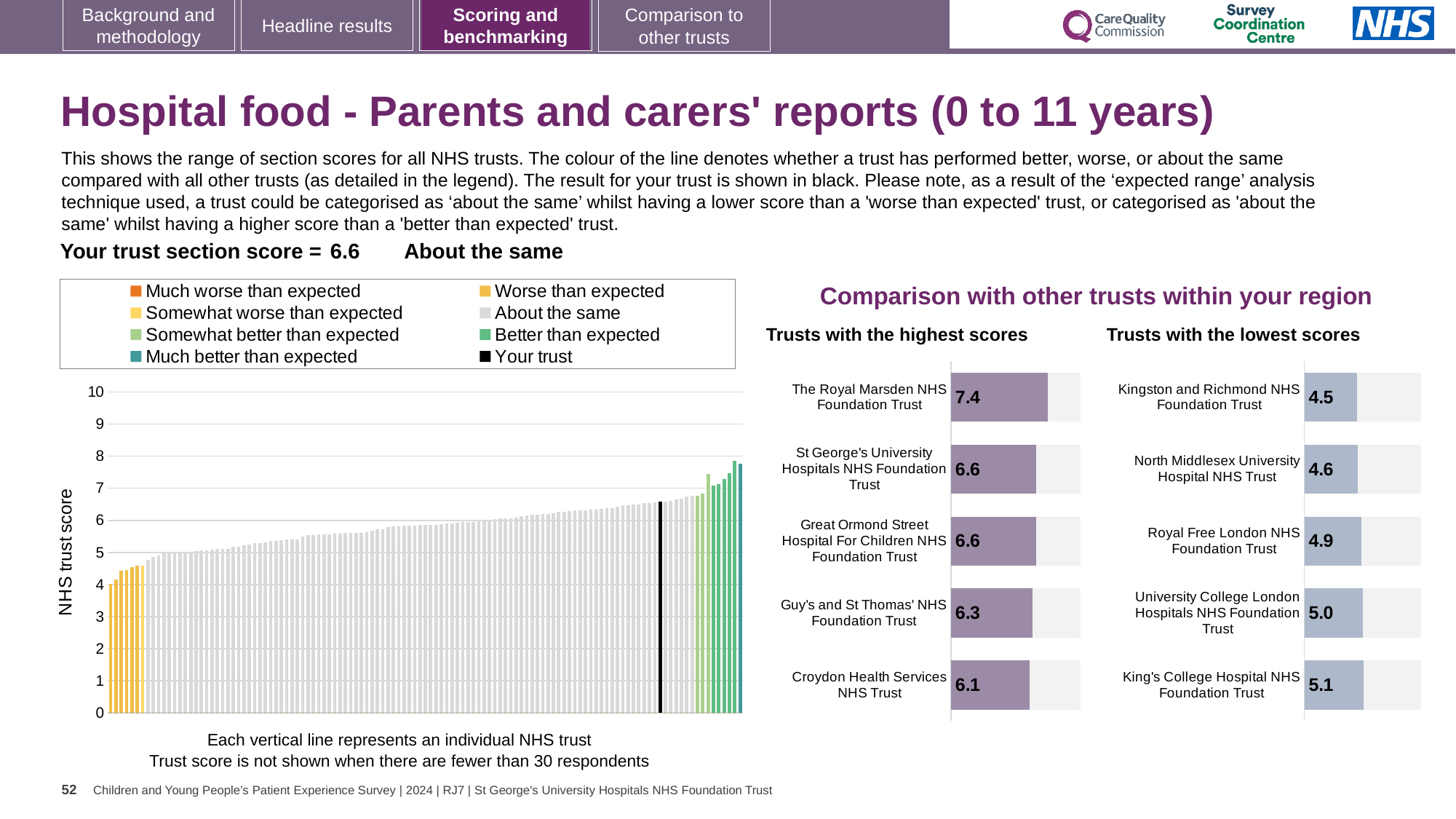
In the 'Trusts with the highest scores' chart, which trust has the lowest score? Croydon Health Services NHS Trust In the 'Trusts with the highest scores' chart, is the score for St George's University Hospitals NHS Foundation Trust larger or smaller than the score for Guy's and St Thomas' NHS Foundation Trust? larger In the 'Trusts with the highest scores' chart, what is the difference between the scores of The Royal Marsden NHS Foundation Trust and Croydon Health Services NHS Trust? 1.3 In the 'Trusts with the lowest scores' chart, what is the score for Royal Free London NHS Foundation Trust? 4.9 In the large chart on the left showing NHS trust scores, do the values rise or fall from left to right? rise In the 'Trusts with the highest scores' chart, what is the score for The Royal Marsden NHS Foundation Trust? 7.4 In the 'Trusts with the lowest scores' chart, which trust has the lowest score? Kingston and Richmond NHS Foundation Trust In the 'Trusts with the highest scores' chart, what is the score for Guy's and St Thomas' NHS Foundation Trust? 6.3 In the 'Trusts with the lowest scores' chart, which trust has the highest score? King's College Hospital NHS Foundation Trust In the 'Trusts with the lowest scores' chart, how many trusts are shown? 5 How many entries does the legend of the large chart on the left list? 8 In the 'Trusts with the lowest scores' chart, what is the difference between the scores of King's College Hospital NHS Foundation Trust and Kingston and Richmond NHS Foundation Trust? 0.6